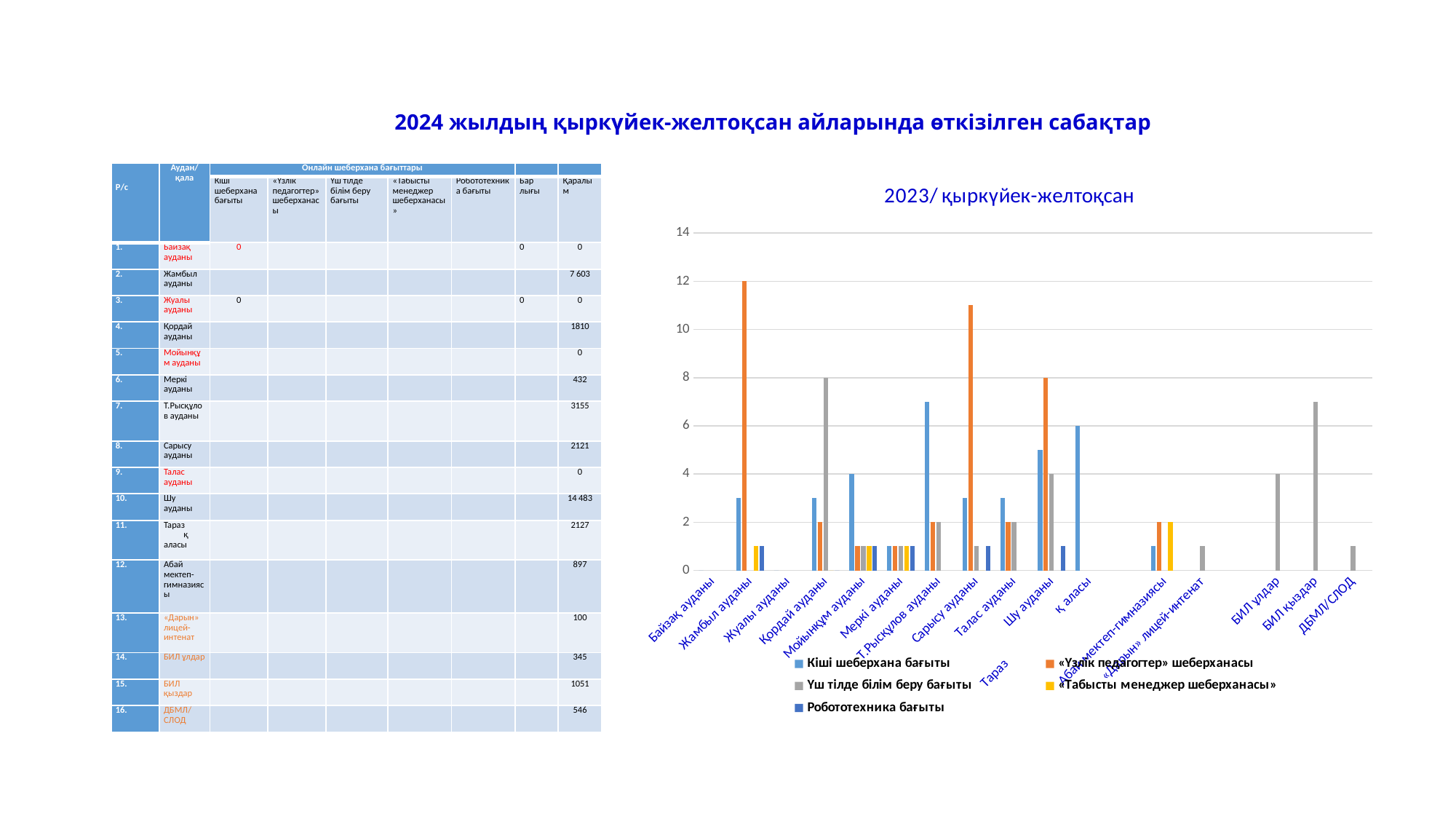
In the bar chart, what is the value of «Үздік педагогтер» шеберханасы for Жамбыл ауданы? 12 Which category has the tallest bar in the bar chart? Жамбыл ауданы In the bar chart, which is larger: Үш тілде білім беру бағыты for Қордай ауданы or Кіші шеберхана бағыты for Тараз қаласы? Үш тілде білім беру бағыты for Қордай ауданы In the bar chart, what is the value of Кіші шеберхана бағыты for Тараз қаласы? 6 In the bar chart, is the value of Кіші шеберхана бағыты for Т.Рысқұлов ауданы greater or less than 6? greater In the bar chart, what is the value of Үш тілде білім беру бағыты for БИЛ ұлдар? 4 How many categories are shown along the x axis of the bar chart? 16 In the bar chart, what is the value of Үш тілде білім беру бағыты for Қордай ауданы? 8 What kind of chart is shown on the right of the slide? bar chart In the bar chart, is the value of «Үздік педагогтер» шеберханасы for Сарысу ауданы greater or less than 10? greater What is the title of the bar chart? 2023/ қыркүйек-желтоқсан How many series does the legend of the bar chart list? 5